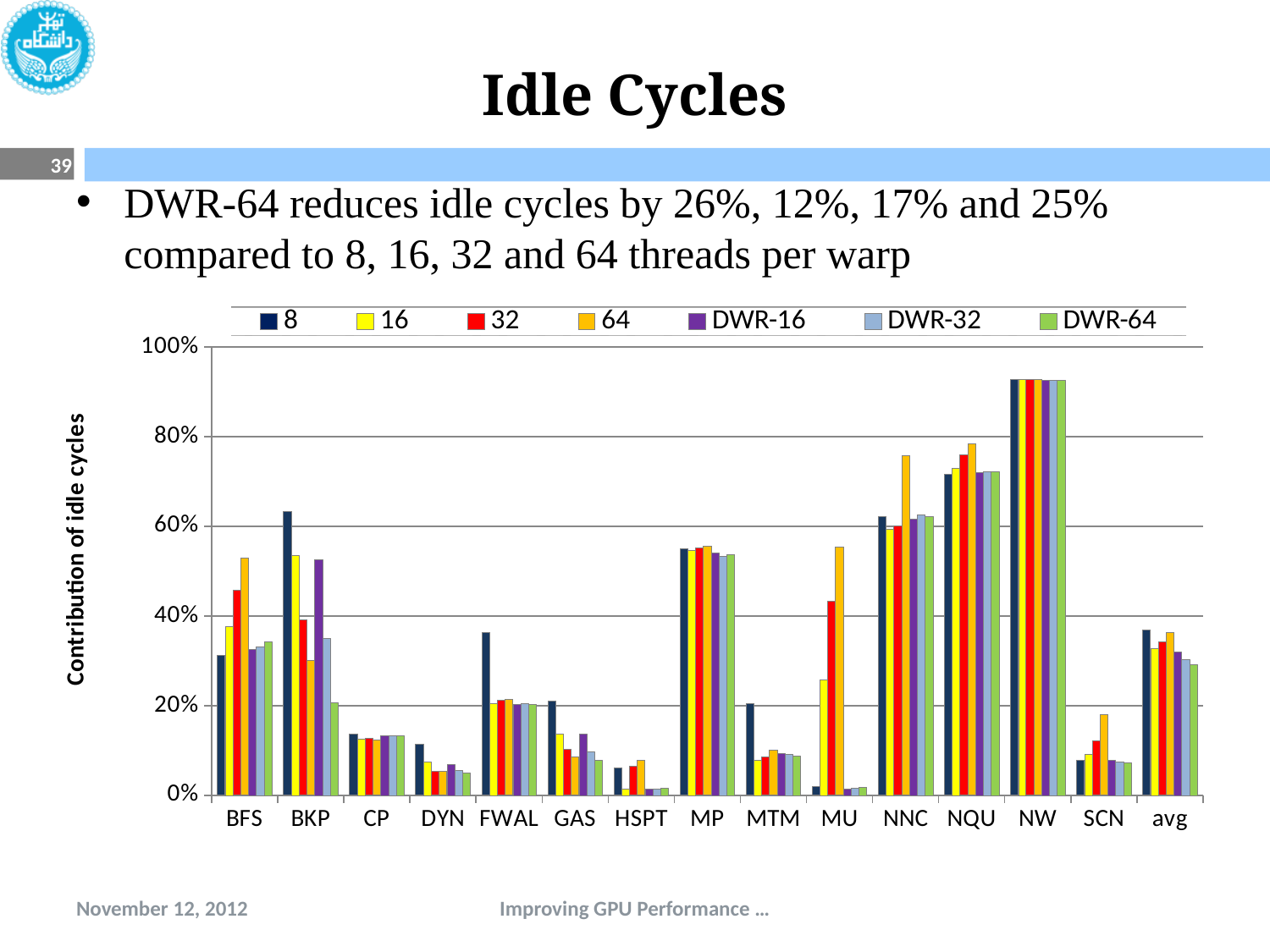
How many categories are shown along the x axis? 15 What kind of chart is shown on the slide? bar chart Is the value for CP in the 8 series greater or less than 20%? less What is the title of the y axis? Contribution of idle cycles For the NNC category, which is larger: the 64 series or the 32 series? 64 Which category has the lowest value for the 8 series? MU For the MU category, which is larger: the 32 series or the 16 series? 32 Is the value for NQU in the 64 series greater or less than 60%? greater Which category has the highest value for the 8 series? NW Is the value for MU in the 64 series greater or less than 40%? greater How many series does the legend list? 7